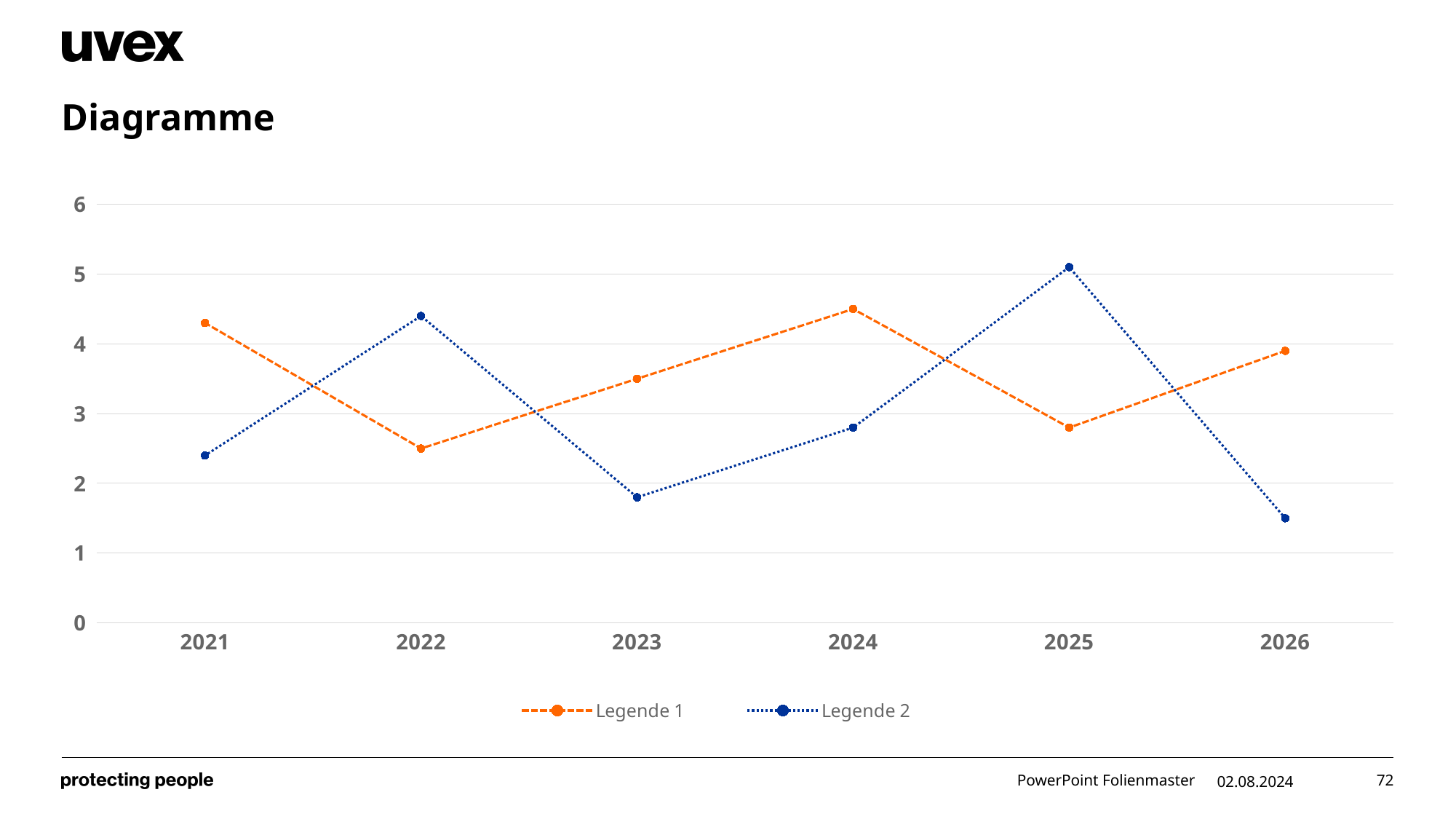
What colour is the line for Legende 1? orange Is the value for Legende 2 in 2023 greater or less than 2? less What kind of chart is shown on the slide? line chart How many years are shown on the x axis? 6 In 2022, which series has the larger value, Legende 1 or Legende 2? Legende 2 Does the value for Legende 2 rise or fall from 2025 to 2026? fall In 2021, which series has the larger value, Legende 1 or Legende 2? Legende 1 In which year does Legende 2 reach its highest value? 2025 Is the value for Legende 1 in 2022 greater or less than 3? less How many series does the legend list? 2 Is the value for Legende 1 in 2024 greater or less than 4? greater